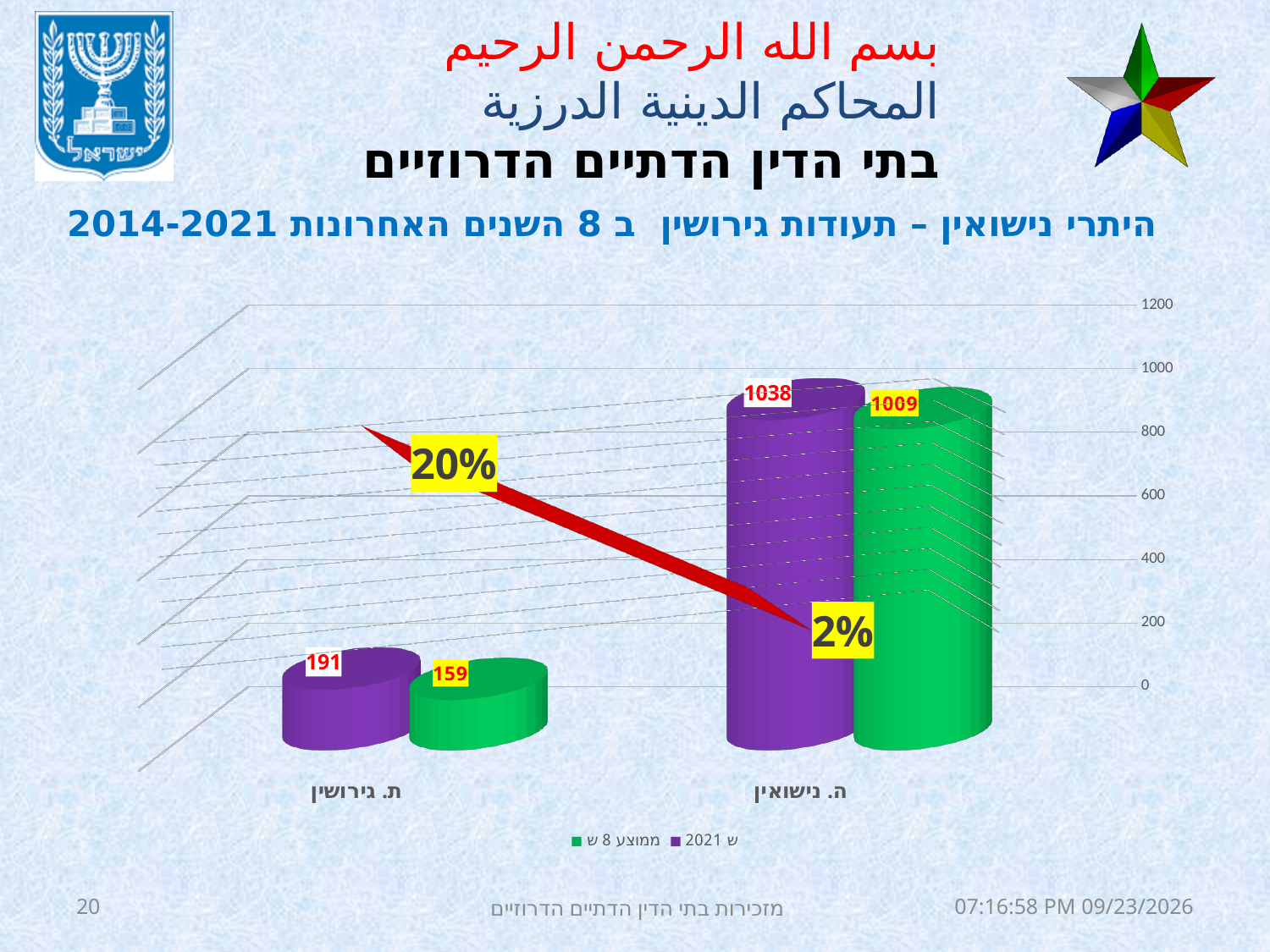
For ה. נישואין, which is larger: the ש 2021 value or the ממוצע 8 ש value? ש 2021 What kind of chart is shown on the slide? Bar chart What is the value for ת. גירושין in the ש 2021 series? 191 What is the value for ת. גירושין in the ממוצע 8 ש series? 159 What is the value for ה. נישואין in the ש 2021 series? 1038 What is the value for ה. נישואין in the ממוצע 8 ש series? 1009 What is the difference between the ש 2021 value and the ממוצע 8 ש value for ת. גירושין? 32 How many categories are shown on the x axis? 2 Which category has the highest value in the ש 2021 series? ה. נישואין What is the difference between the ש 2021 value and the ממוצע 8 ש value for ה. נישואין? 29 Which category has the lowest value in the ממוצע 8 ש series? ת. גירושין How many series does the legend list? 2